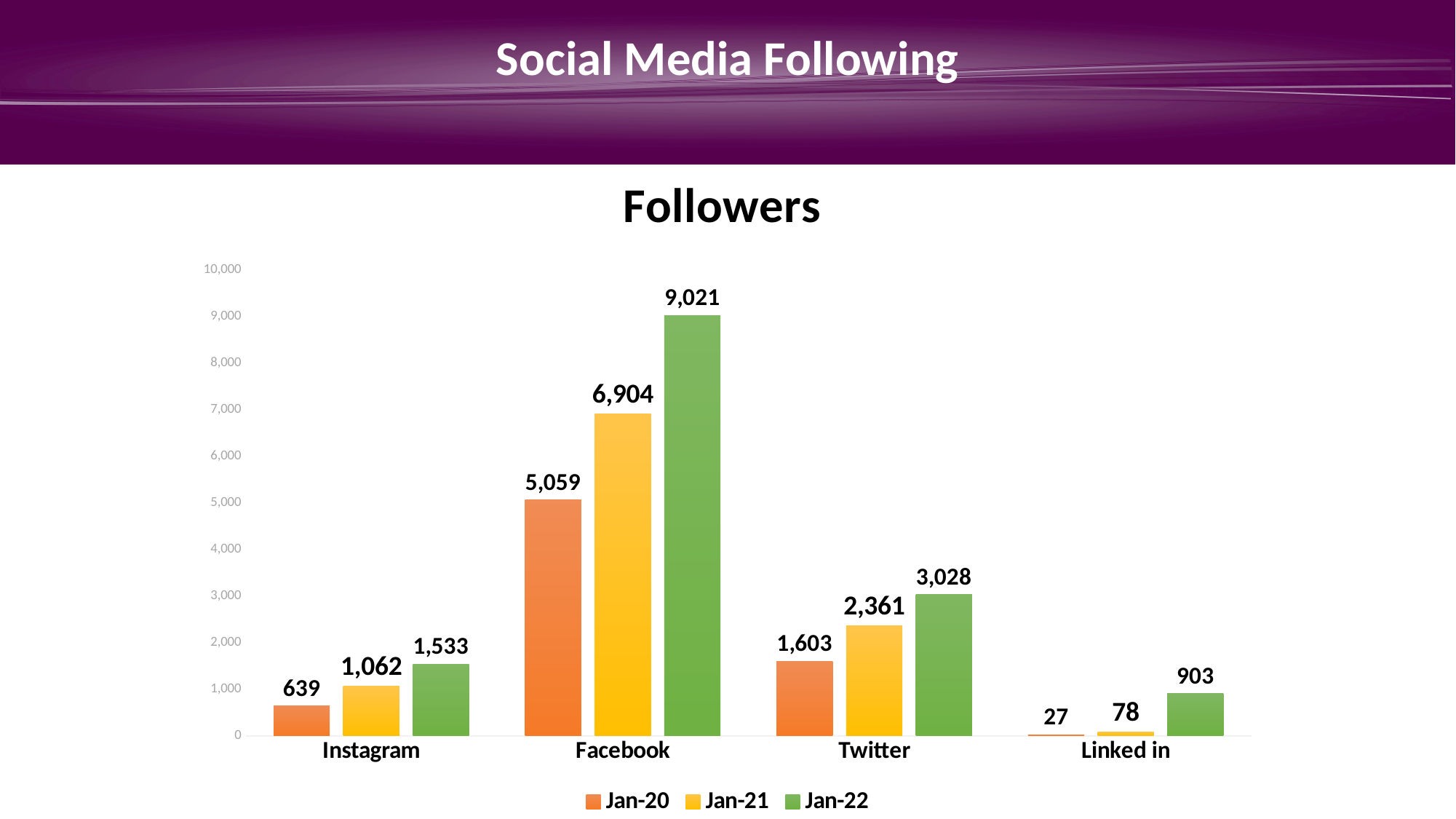
What kind of chart is shown? bar chart Which platform has the lowest Jan-20 followers? Linked in Do the Twitter values rise or fall from Jan-20 to Jan-22? rise What is the Jan-21 value for Linked in? 78 How many series does the legend list? 3 What is the Jan-20 value for Twitter? 1,603 What is the difference between the Jan-22 and Jan-20 values for Instagram? 894 Is the Jan-21 value for Facebook greater or less than 7,000? less How many platforms are shown on the x axis? 4 What is the Jan-22 value for Facebook? 9,021 Which platform has the highest Jan-22 followers? Facebook Which is larger: the Jan-21 value for Twitter or the Jan-22 value for Instagram? Jan-21 value for Twitter